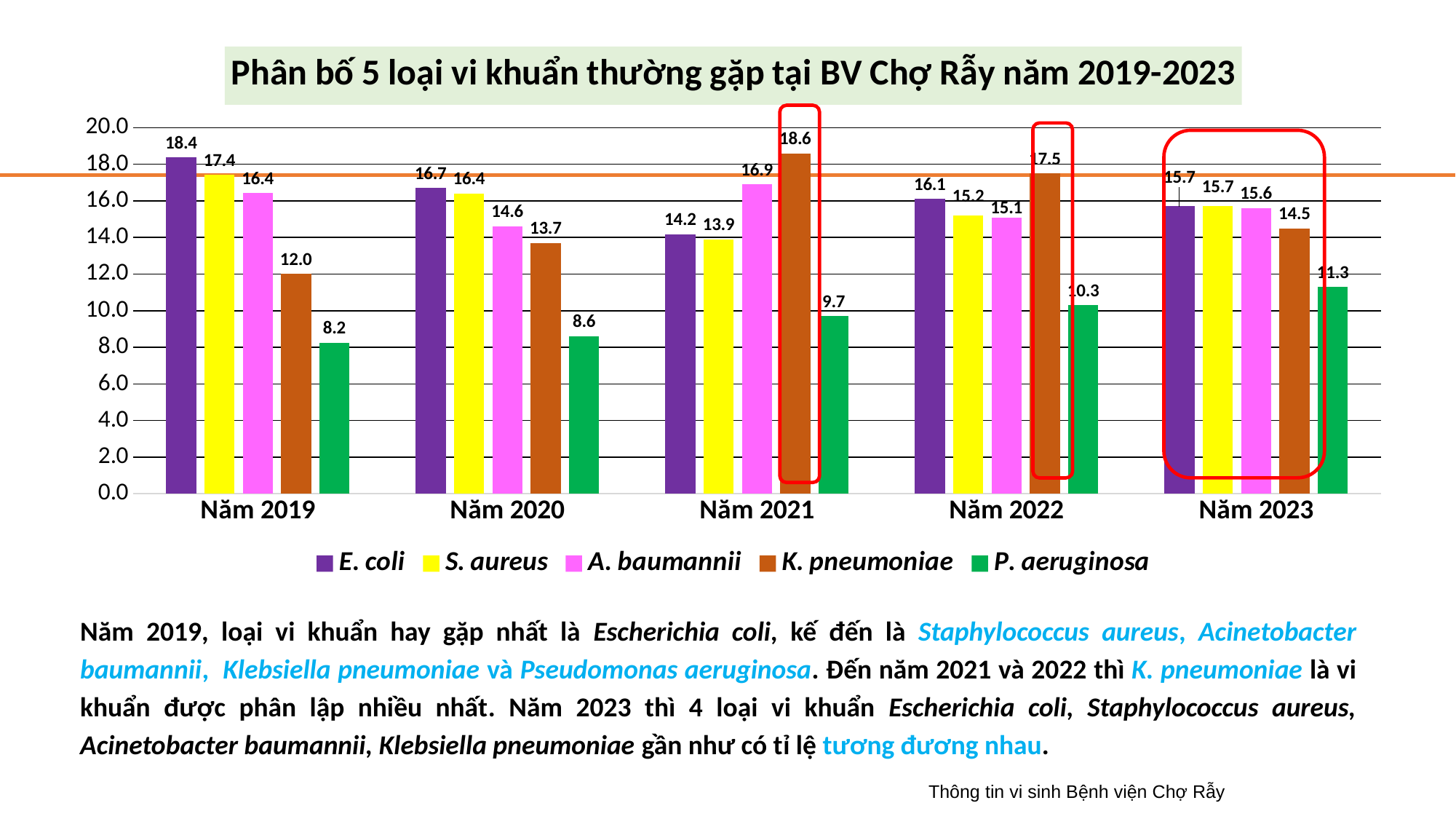
What is the difference between the E. coli value and the P. aeruginosa value in Năm 2019? 10.2 What kind of chart is shown on the slide? bar chart What is the value for K. pneumoniae in Năm 2021? 18.6 Is the value for K. pneumoniae in Năm 2019 greater or less than 14.0? less What is the value for P. aeruginosa in Năm 2023? 11.3 Which series has the highest value in Năm 2022? K. pneumoniae What is the value for E. coli in Năm 2019? 18.4 Does the value for P. aeruginosa rise or fall from Năm 2019 to Năm 2023? rise Which is larger in Năm 2021: the value for A. baumannii or the value for S. aureus? A. baumannii How many series does the legend list? 5 How many years are shown on the x axis? 5 Which series has the lowest value in Năm 2020? P. aeruginosa